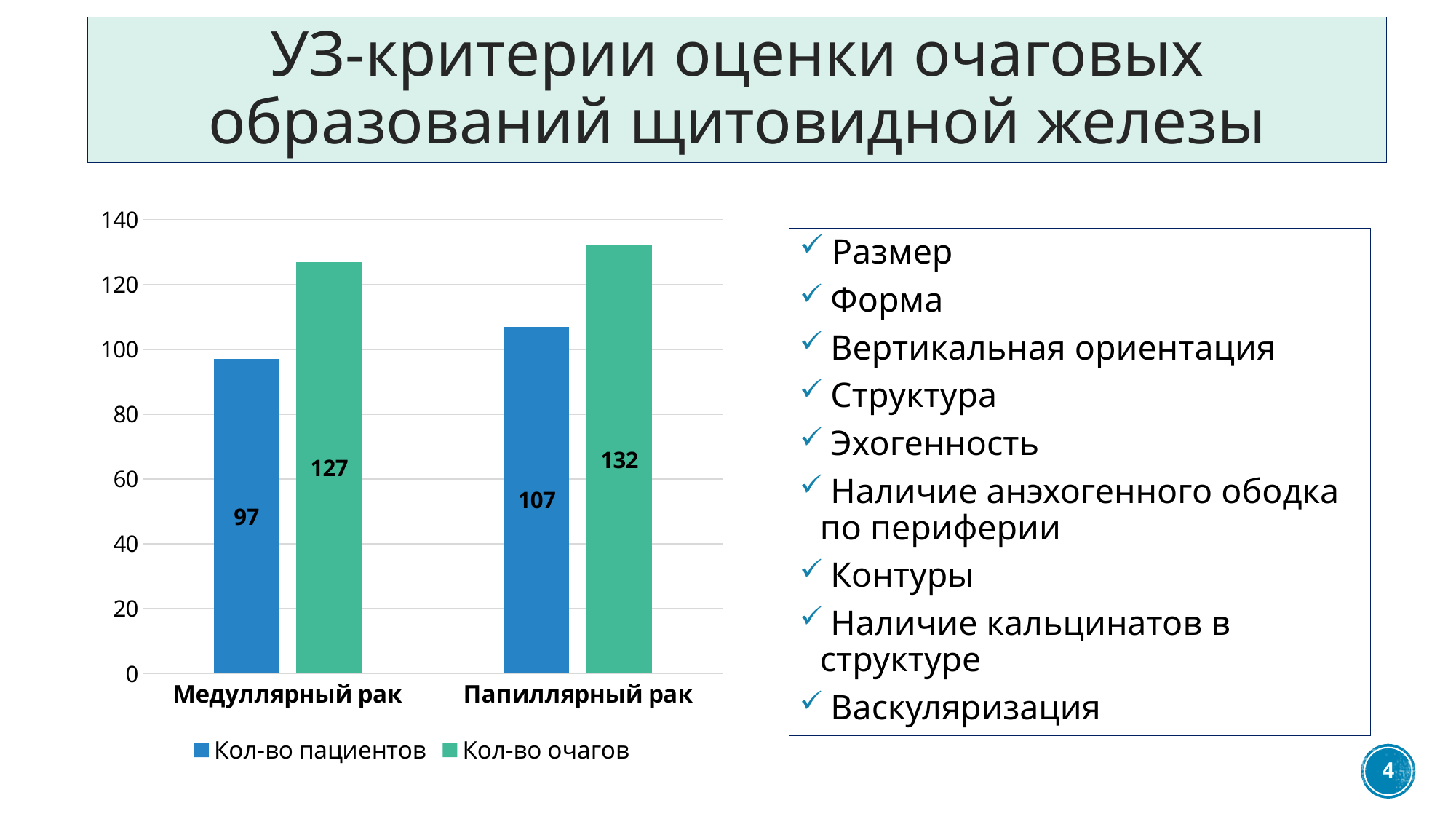
What is the value of Кол-во очагов for Папиллярный рак? 132 Which is larger: Кол-во очагов for Медуллярный рак or Кол-во пациентов for Папиллярный рак? Кол-во очагов for Медуллярный рак Which category has the higher value for Кол-во очагов? Папиллярный рак What is the value of Кол-во пациентов for Папиллярный рак? 107 What kind of chart is shown on the slide? Bar chart How many categories are shown on the x axis? 2 What is the difference between Кол-во очагов and Кол-во пациентов for Медуллярный рак? 30 What is the value of Кол-во очагов for Медуллярный рак? 127 Which category has the lower value for Кол-во пациентов? Медуллярный рак What is the difference in Кол-во пациентов between Папиллярный рак and Медуллярный рак? 10 What is the value of Кол-во пациентов for Медуллярный рак? 97 How many series does the legend list? 2